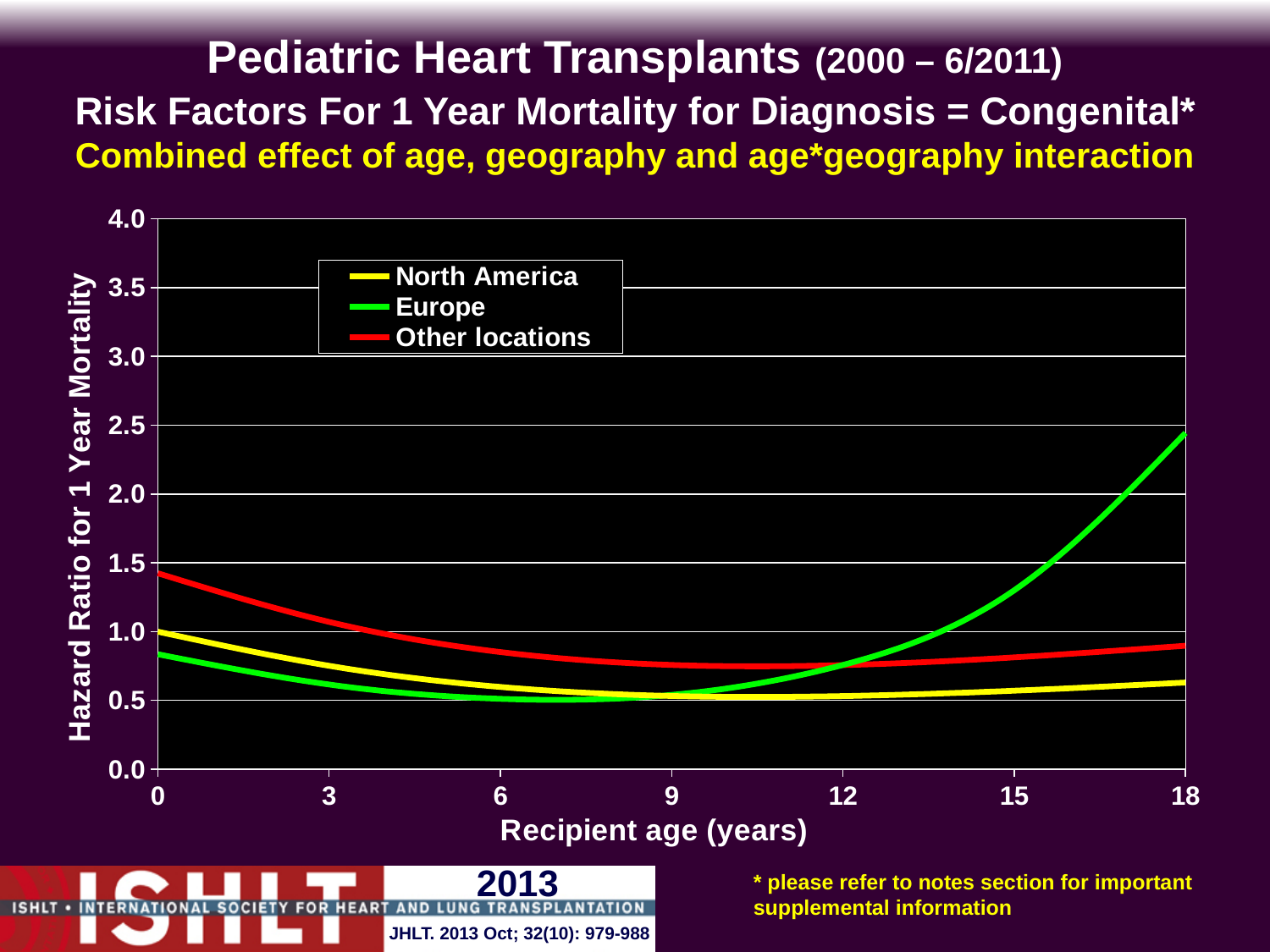
At recipient age 0, which series has the higher hazard ratio, Other locations or Europe? Other locations Is the hazard ratio for Europe at recipient age 18 greater or less than 2.0? greater What is the label of the x axis of the chart? Recipient age (years) Which series has the lowest hazard ratio at recipient age 0? Europe Which three series are listed in the chart legend? North America, Europe, Other locations How many series does the chart legend list? 3 At recipient age 18, which series has the higher hazard ratio, Europe or North America? Europe Is the hazard ratio for Europe at recipient age 6 greater or less than 1.0? less Does the hazard ratio for Europe rise or fall as recipient age increases from 12 to 18 years? rise Is the hazard ratio for Other locations at recipient age 0 greater or less than 1.0? greater What kind of chart is shown on the slide? line chart